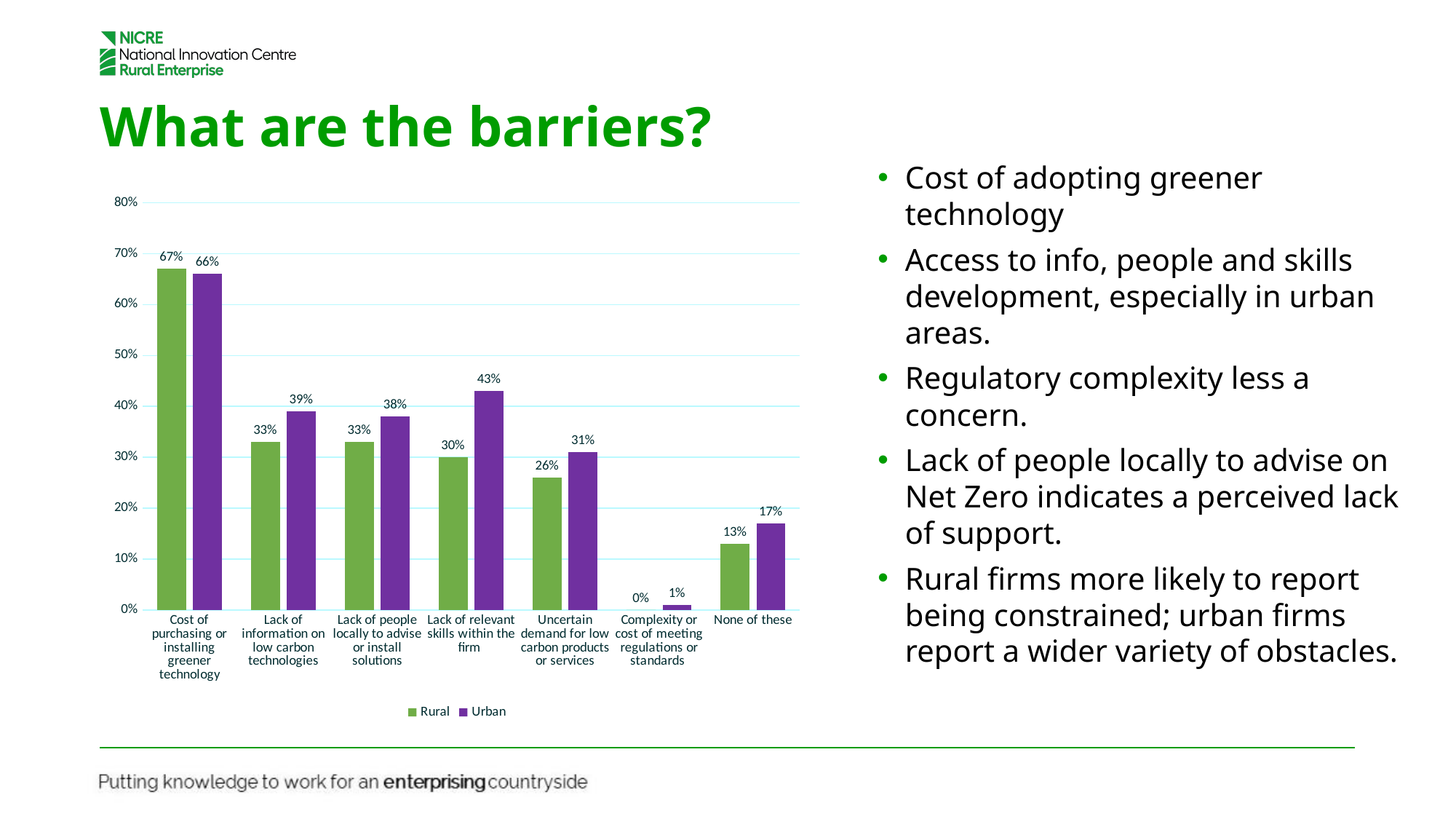
What is the Rural value for 'Uncertain demand for low carbon products or services'? 26% How many series does the legend list? 2 Is the Urban value for 'Lack of information on low carbon technologies' greater or less than 30%? greater Which colour represents the Urban series in the chart? Purple What is the Urban value for 'Lack of relevant skills within the firm'? 43% What kind of chart is shown on the slide? Bar chart How many categories are shown on the x axis? 7 Which category has the lowest Rural value? Complexity or cost of meeting regulations or standards For 'None of these', which series has the larger value, Rural or Urban? Urban What is the difference between the Urban and Rural values for 'Lack of relevant skills within the firm'? 13% What is the Rural value for 'Cost of purchasing or installing greener technology'? 67% Which category has the highest Urban value? Cost of purchasing or installing greener technology